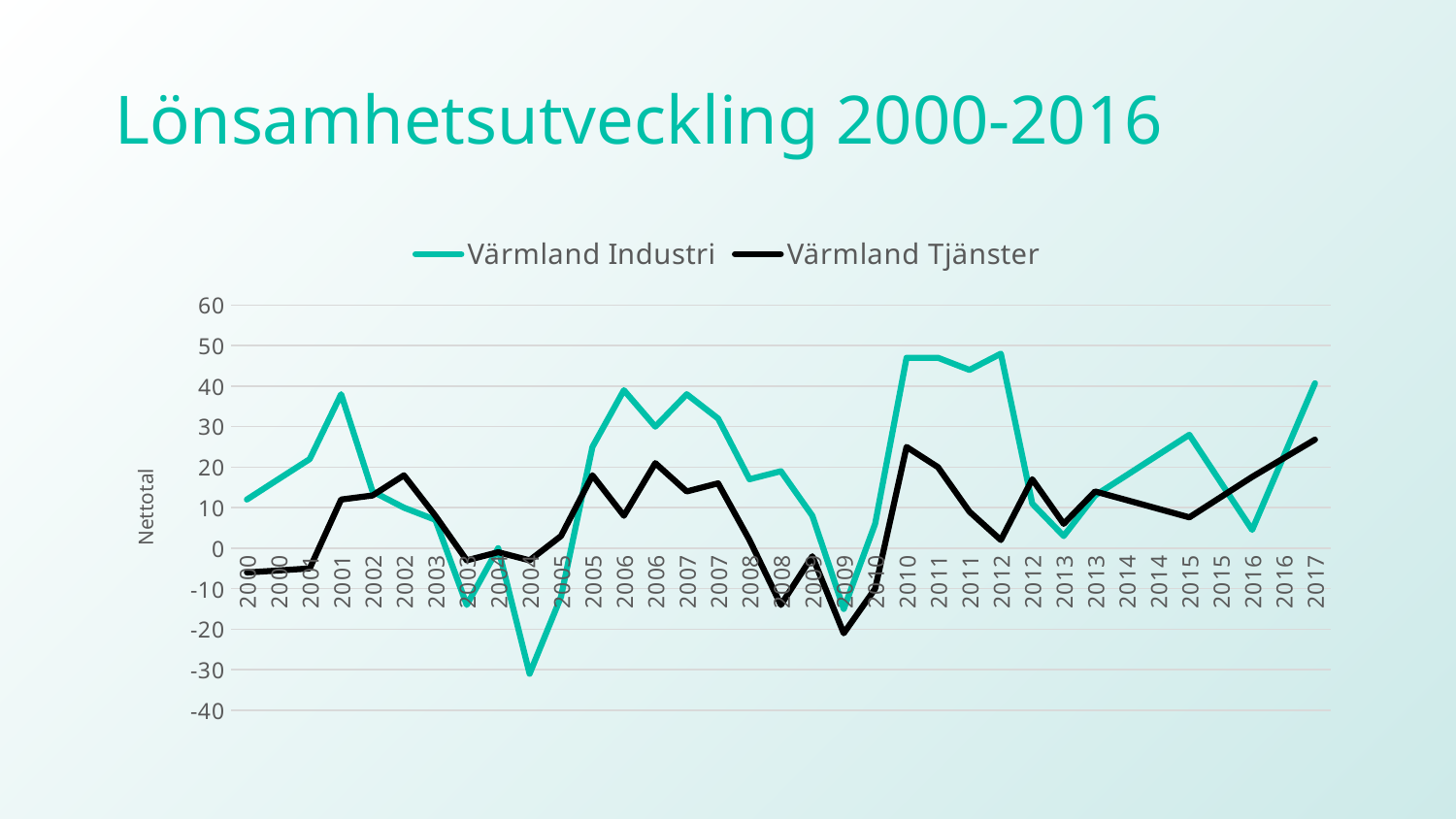
What is the label on the vertical axis? Nettotal What is the title of the slide's chart? Lönsamhetsutveckling 2000-2016 Which series reaches the lowest value on the chart? Värmland Industri Is the value for Värmland Tjänster at the last point (2017) greater or less than 20? greater Is the lowest value of Värmland Tjänster (around 2009) greater or less than -10? less How many series does the legend list? 2 Which series reaches the highest value on the chart? Värmland Industri What kind of chart is shown on the slide? line chart Do both series rise or fall between 2016 and 2017? rise Is the value for Värmland Industri at the last point (2017) greater or less than 30? greater At the last point (2017), which series has the higher value, Värmland Industri or Värmland Tjänster? Värmland Industri